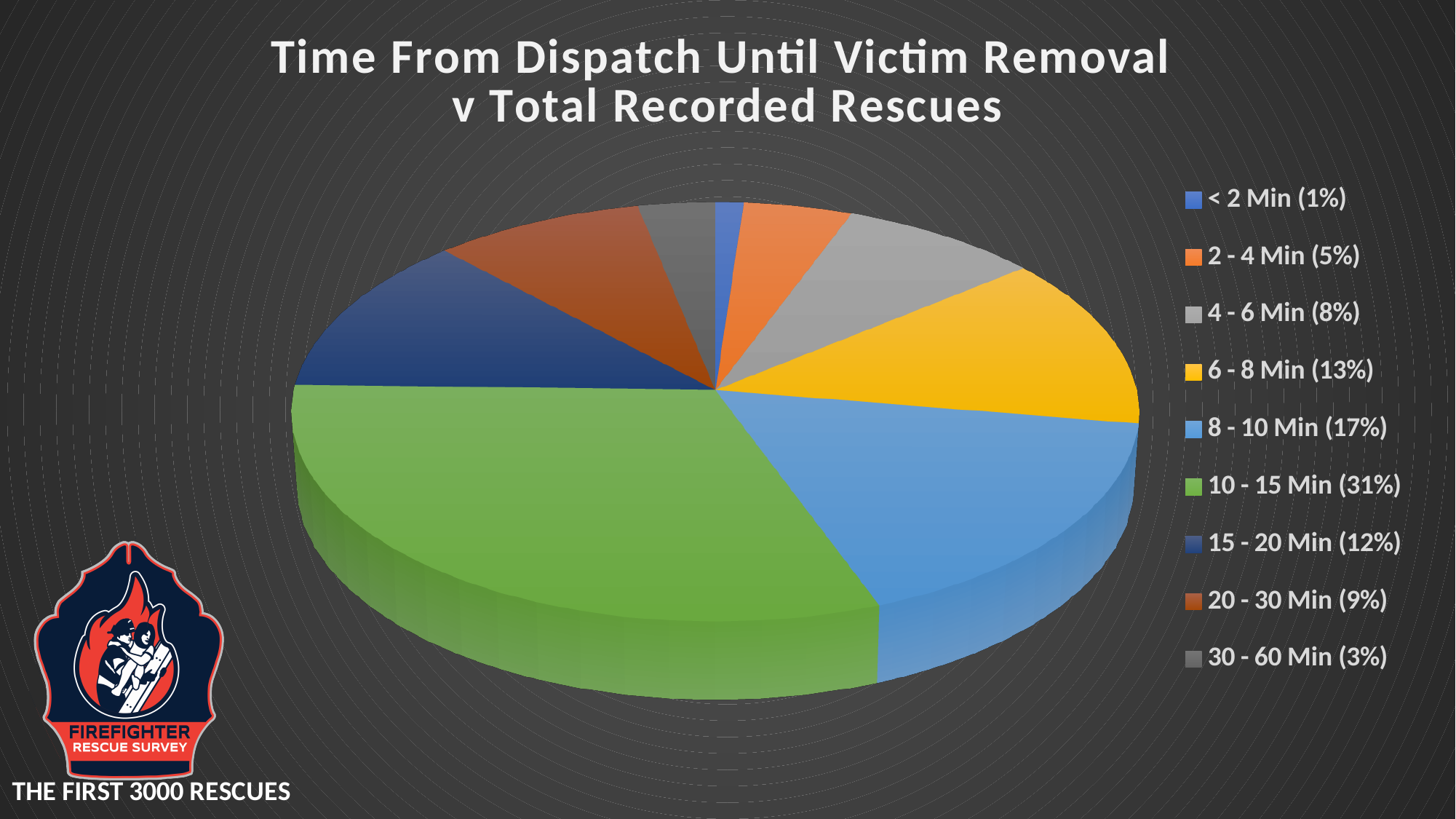
What share of rescues falls in the 10 - 15 Min category? 31% How many time categories does the pie chart show? 9 What colour is the slice for the 6 - 8 Min category? Yellow What is the title of the chart? Time From Dispatch Until Victim Removal v Total Recorded Rescues Which has a larger share, 6 - 8 Min or 15 - 20 Min? 6 - 8 Min What is the difference in percentage points between the 10 - 15 Min and 8 - 10 Min categories? 14 Which has a larger share, 4 - 6 Min or 30 - 60 Min? 4 - 6 Min Which time category has the largest share of rescues? 10 - 15 Min What share of rescues falls in the 20 - 30 Min category? 9% What share of rescues falls in the 8 - 10 Min category? 17% Which time category has the smallest share of rescues? < 2 Min What kind of chart is shown on the slide? Pie chart